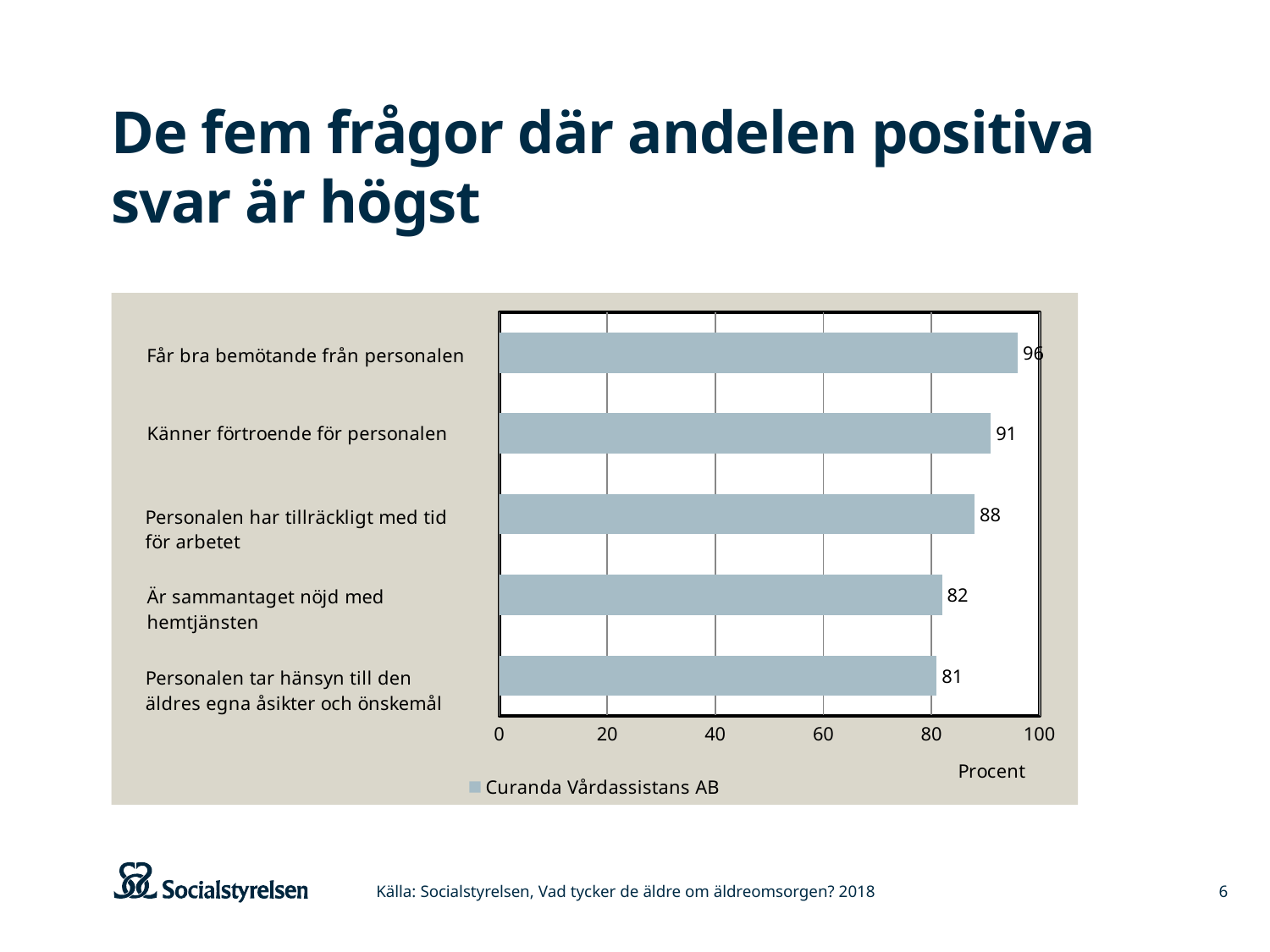
Which is larger: the value for "Personalen har tillräckligt med tid för arbetet" or for "Är sammantaget nöjd med hemtjänsten"? Personalen har tillräckligt med tid för arbetet What is the value for "Personalen tar hänsyn till den äldres egna åsikter och önskemål"? 81 What series name does the legend show? Curanda Vårdassistans AB What kind of chart is shown on the slide? Bar chart What is the value for "Känner förtroende för personalen"? 91 What is the difference between the values for "Får bra bemötande från personalen" and "Känner förtroende för personalen"? 5 What is the value for "Är sammantaget nöjd med hemtjänsten"? 82 Which category has the lowest value? Personalen tar hänsyn till den äldres egna åsikter och önskemål What is the value for "Får bra bemötande från personalen"? 96 Which category has the highest value? Får bra bemötande från personalen How many categories are shown in the chart? 5 What is the value for "Personalen har tillräckligt med tid för arbetet"? 88